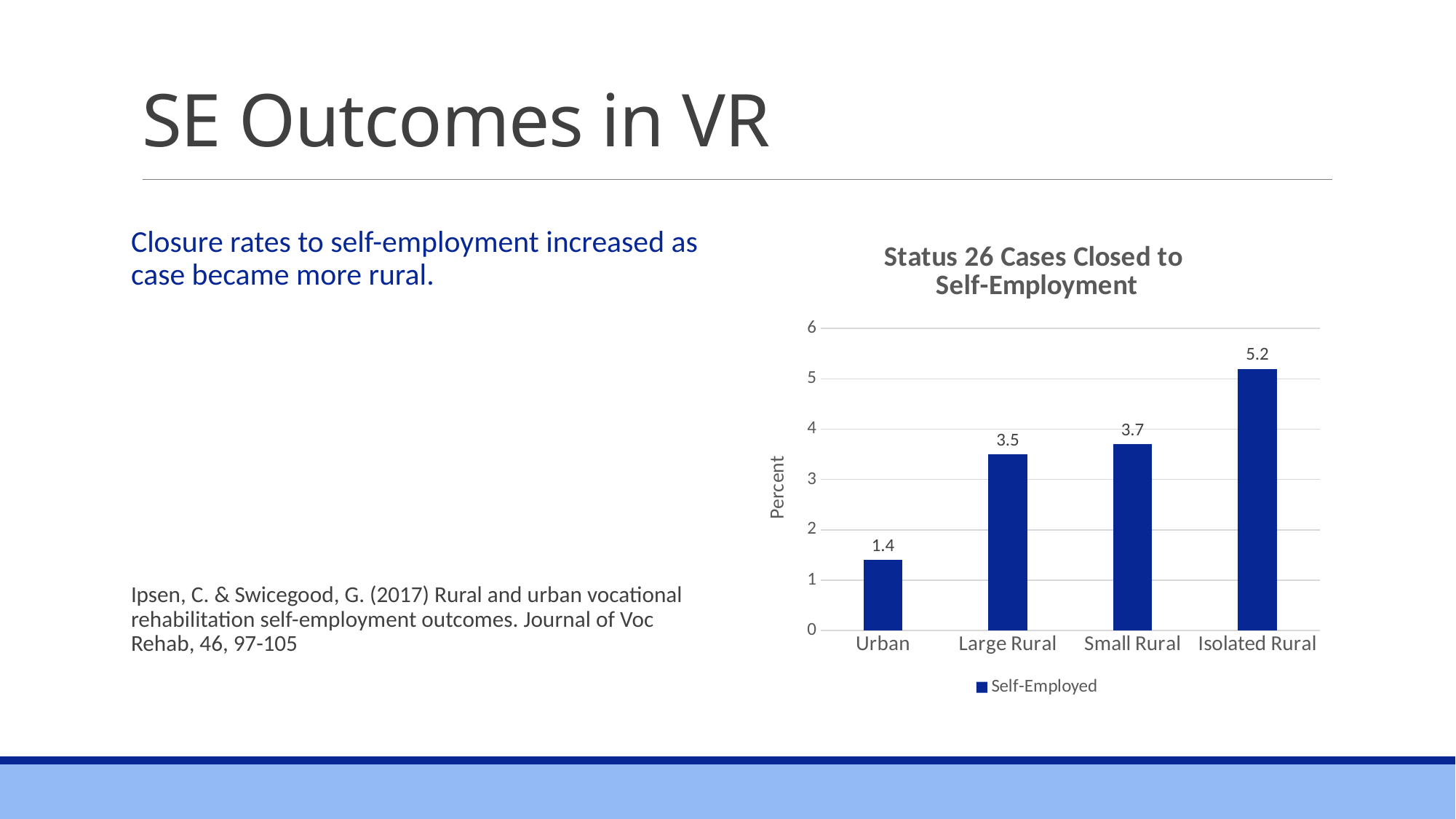
Do the values rise or fall from Urban to Isolated Rural? rise Which category has the lowest value? Urban Which category has the highest value? Isolated Rural What is the value for Urban? 1.4 What kind of chart is shown? bar chart Which is larger, the value for Small Rural or the value for Large Rural? Small Rural How many series does the legend list? 1 Is the value for Small Rural greater or less than 4? less How many categories are shown on the x axis? 4 What is the difference between the values for Isolated Rural and Urban? 3.8 What is the value for Isolated Rural? 5.2 What is the value for Large Rural? 3.5